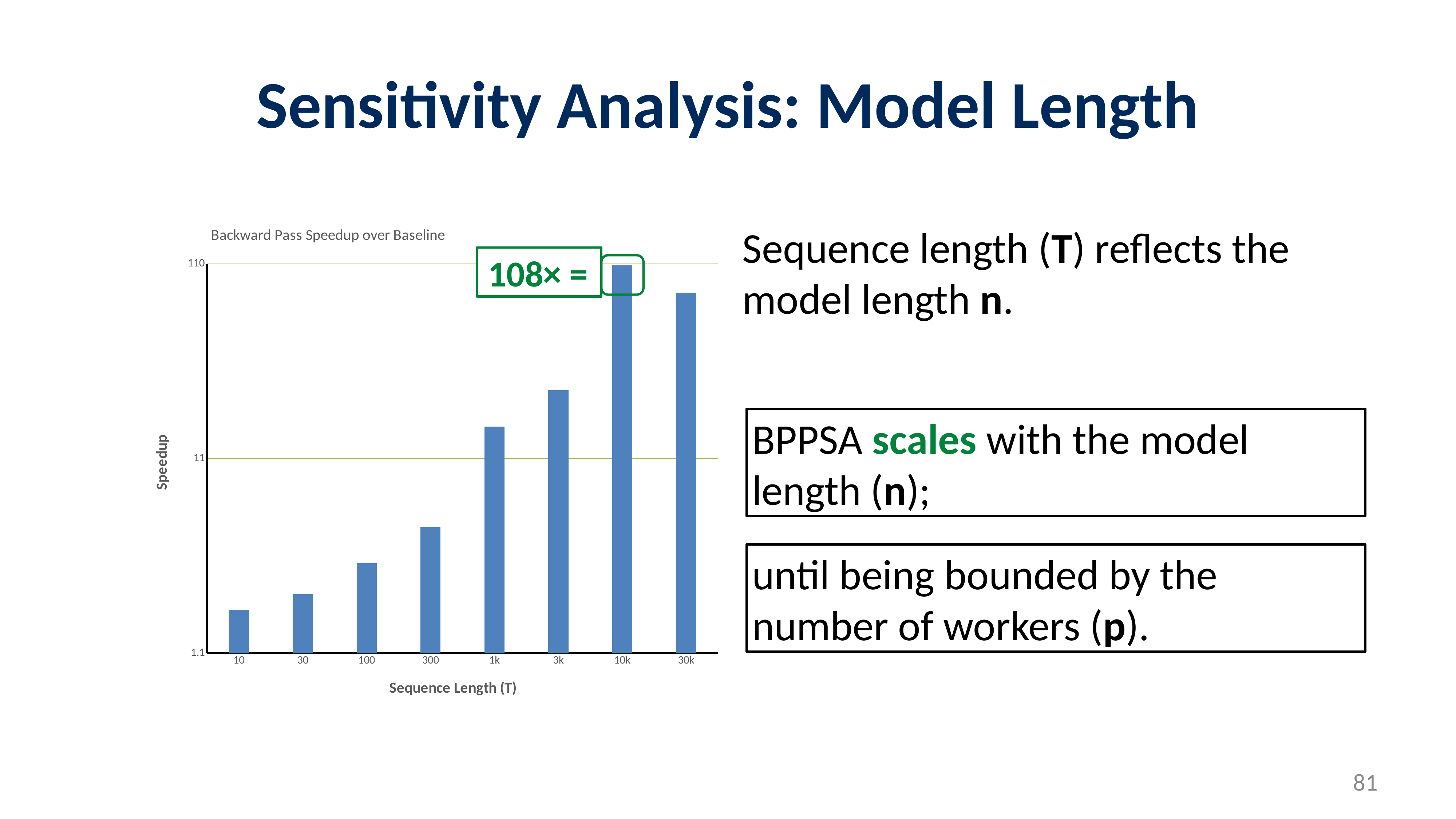
Do the speedup values rise or fall as sequence length increases from 10 to 10k? rise What speedup is annotated for the sequence length 10k bar? 108× What kind of chart is shown on the slide? bar chart Is the speedup for sequence length 30k greater or less than 11? greater Is the speedup for sequence length 1k greater or less than 11? greater Is the speedup for sequence length 300 greater or less than 11? less Which sequence length has the lowest speedup? 10 What is the label of the y axis? Speedup How many sequence length categories are plotted on the x axis? 8 What is the title of the chart? Backward Pass Speedup over Baseline Which has the larger speedup, sequence length 10k or 30k? 10k Which sequence length has the highest speedup? 10k